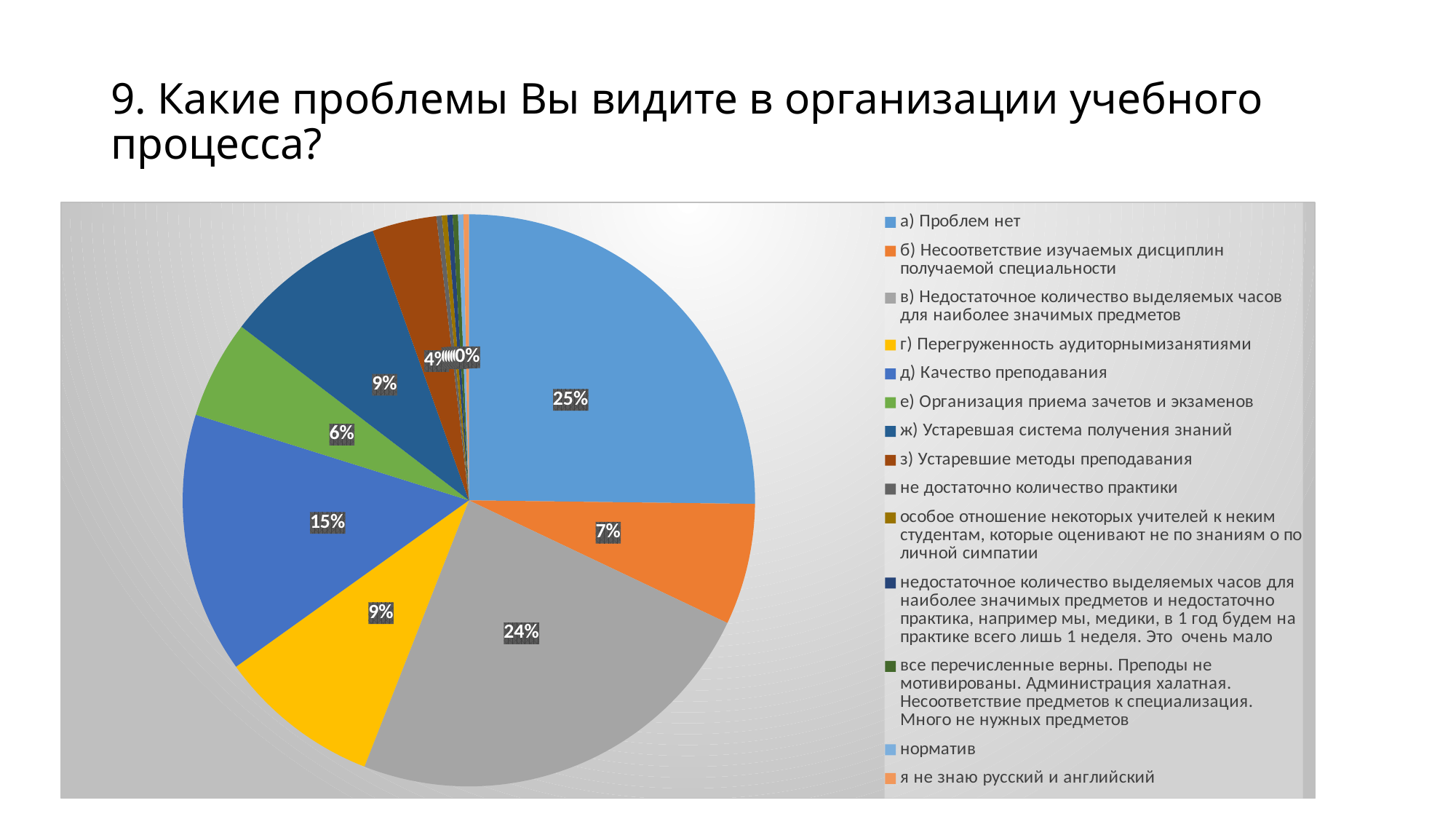
What share of the pie does "а) Проблем нет" take? 25% Which category has the largest slice of the pie? а) Проблем нет Which is larger: the slice for "д) Качество преподавания" or the slice for "г) Перегруженность аудиторными занятиями"? д) Качество преподавания What percentage is shown for "б) Несоответствие изучаемых дисциплин получаемой специальности"? 7% What kind of chart is shown on the slide? pie chart What percentage is shown for "з) Устаревшие методы преподавания"? 4% How many entries does the legend list? 14 What percentage is shown for "е) Организация приема зачетов и экзаменов"? 6% What is the difference in percentage points between "а) Проблем нет" and "б) Несоответствие изучаемых дисциплин получаемой специальности"? 18% What percentage is shown for "д) Качество преподавания"? 15% What percentage is shown for "в) Недостаточное количество выделяемых часов для наиболее значимых предметов"? 24% What colour is the slice for "г) Перегруженность аудиторными занятиями"? yellow